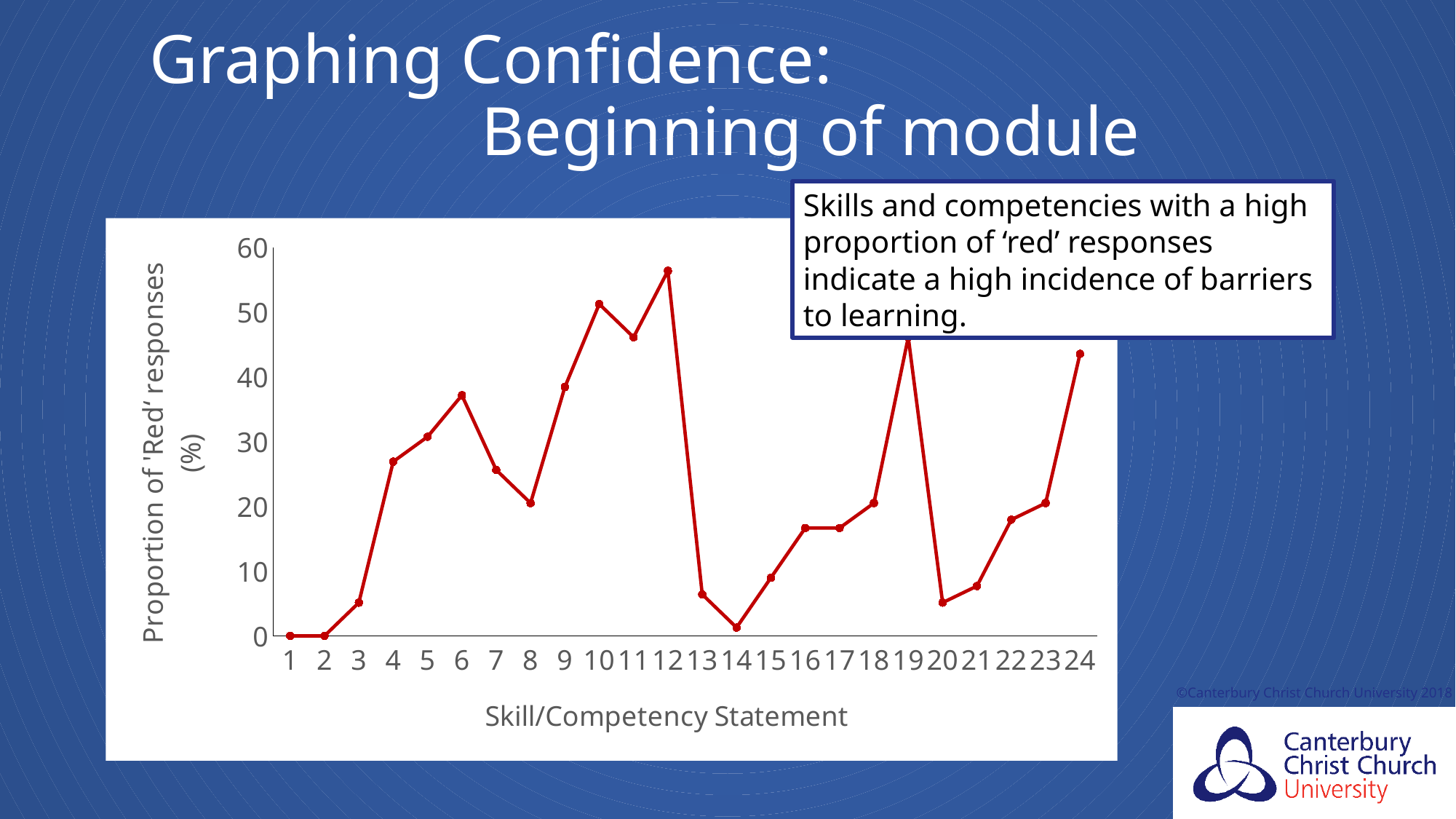
How many skill/competency statements are plotted along the x axis? 24 Is the value for statement 24 greater or less than 40? greater Which skill/competency statement has the highest proportion of 'Red' responses? 12 Is the value for statement 14 greater or less than 10? less What is the proportion of 'Red' responses for statement 1? 0 What is the label of the x axis? Skill/Competency Statement What is the proportion of 'Red' responses for statement 2? 0 Which has a higher proportion of 'Red' responses, statement 12 or statement 13? 12 Which has a higher proportion of 'Red' responses, statement 6 or statement 7? 6 Do the values rise or fall from statement 12 to statement 14? fall What kind of chart is shown on the slide? line chart Is the value for statement 12 greater or less than 50? greater